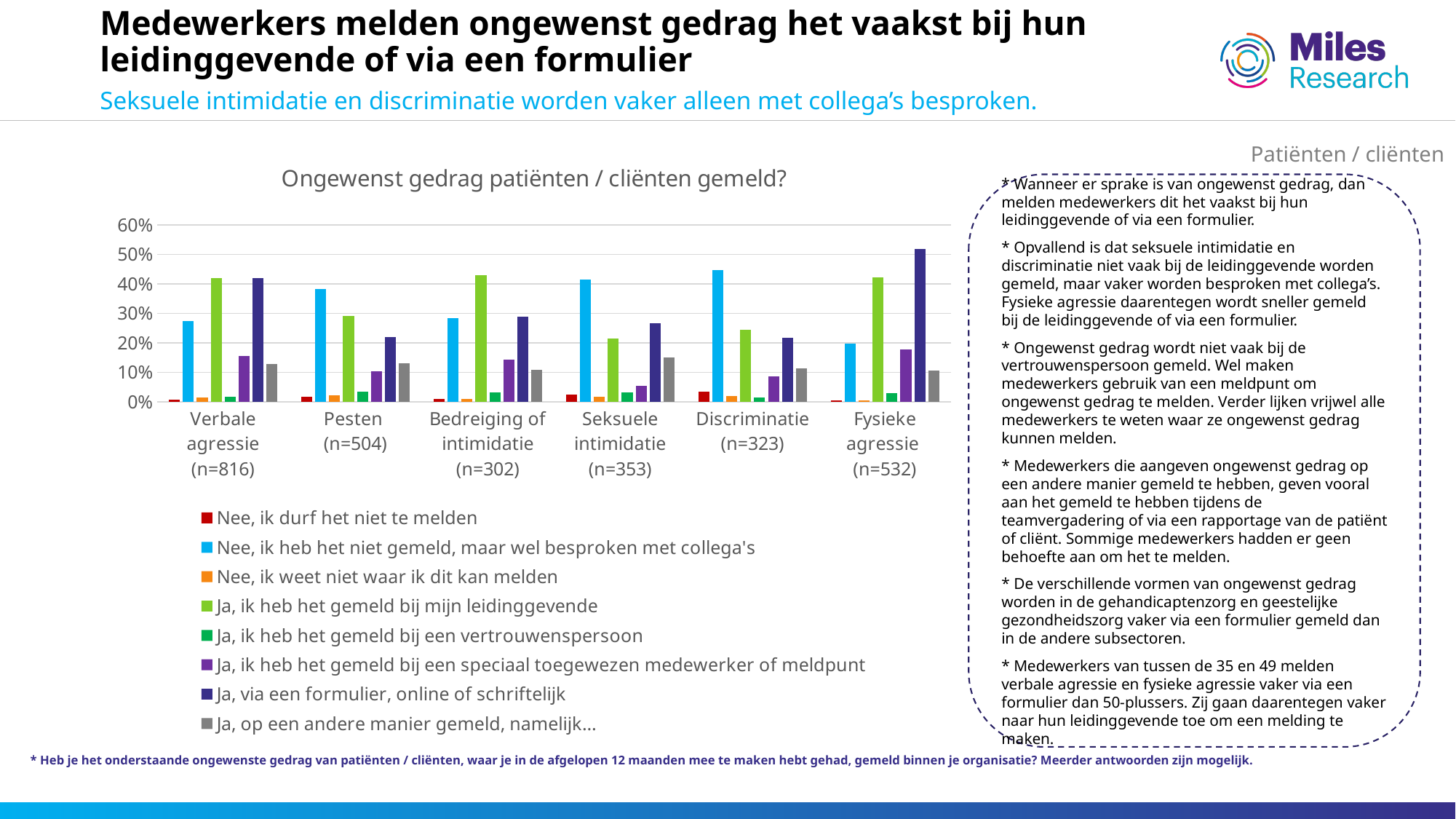
What kind of chart is shown on the slide? bar chart Which category has the lowest value for 'Nee, ik heb het niet gemeld, maar wel besproken met collega's'? Fysieke agressie For Pesten, which is larger: 'Nee, ik heb het niet gemeld, maar wel besproken met collega's' or 'Ja, ik heb het gemeld bij mijn leidinggevende'? Nee, ik heb het niet gemeld, maar wel besproken met collega's Is the value for 'Ja, via een formulier, online of schriftelijk' at Fysieke agressie greater or less than 50%? greater How many categories of ongewenst gedrag are shown on the x axis? 6 For Seksuele intimidatie, which is larger: 'Nee, ik heb het niet gemeld, maar wel besproken met collega's' or 'Ja, via een formulier, online of schriftelijk'? Nee, ik heb het niet gemeld, maar wel besproken met collega's Which category has the highest value for 'Ja, via een formulier, online of schriftelijk'? Fysieke agressie Which category has the highest value for 'Nee, ik heb het niet gemeld, maar wel besproken met collega's'? Discriminatie How many series does the legend list? 8 Is the value for 'Nee, ik heb het niet gemeld, maar wel besproken met collega's' at Discriminatie greater or less than 40%? greater Is the value for 'Ja, via een formulier, online of schriftelijk' at Pesten greater or less than 30%? less What is the title of the chart? Ongewenst gedrag patiënten / cliënten gemeld?